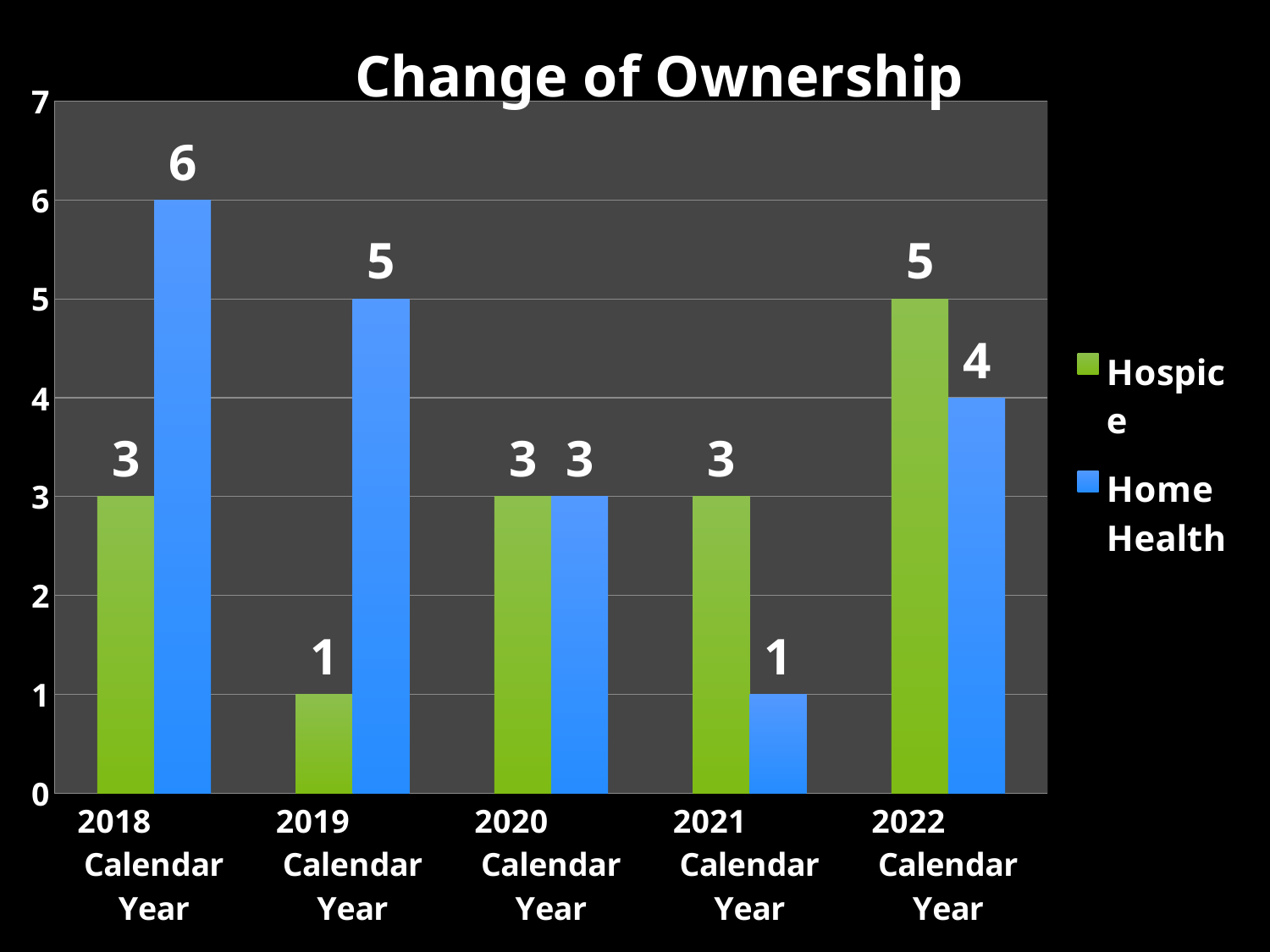
How many calendar years are shown on the x axis? 5 Which is larger for 2021 Calendar Year, Hospice or Home Health? Hospice How many series does the legend list? 2 Is the Home Health value for 2022 Calendar Year greater or less than 3? greater Which calendar year has the highest Home Health value? 2018 Calendar Year Which calendar year has the lowest Hospice value? 2019 Calendar Year What is the Hospice value for 2019 Calendar Year? 1 What is the title of the chart? Change of Ownership What is the difference between the Home Health and Hospice values for 2019 Calendar Year? 4 What is the Hospice value for 2022 Calendar Year? 5 What is the Home Health value for 2018 Calendar Year? 6 What kind of chart is shown? Bar chart